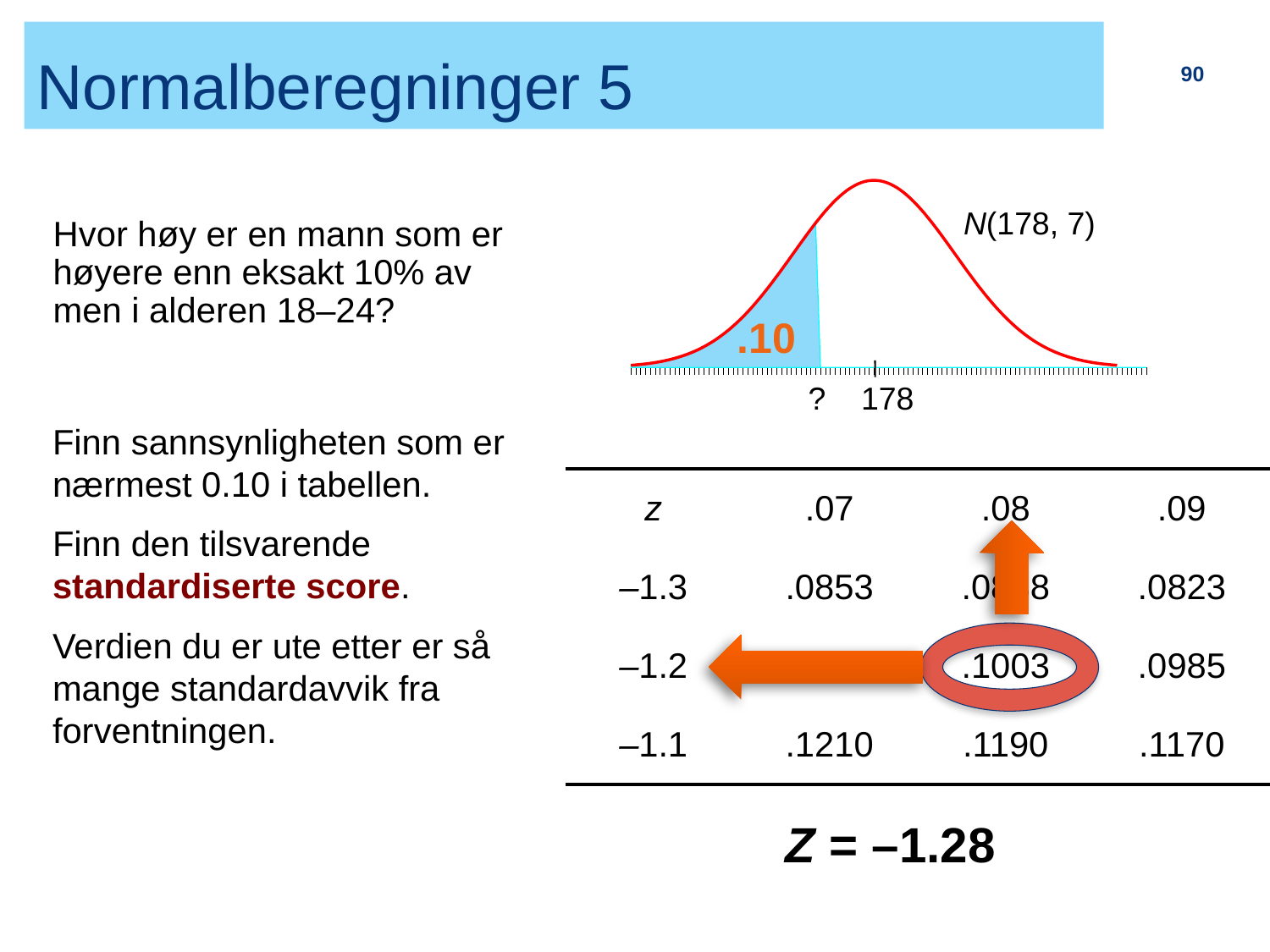
What value is marked at the centre tick of the horizontal axis? 178 What value is printed on the shaded area under the curve? .10 What distribution is labelled next to the curve? N(178, 7) What colour is the curve drawn in? red What is the standard deviation of the normal distribution shown on the chart? 7 What kind of chart is shown at the top right of the slide? a normal distribution curve (line chart) Is the shaded region on the left or the right side of the curve? left Is the unknown value marked '?' on the axis to the left or the right of 178? left What is the mean of the normal distribution shown on the chart? 178 What symbol marks the unknown height on the horizontal axis? ? What standardised score Z is given below the table? Z = –1.28